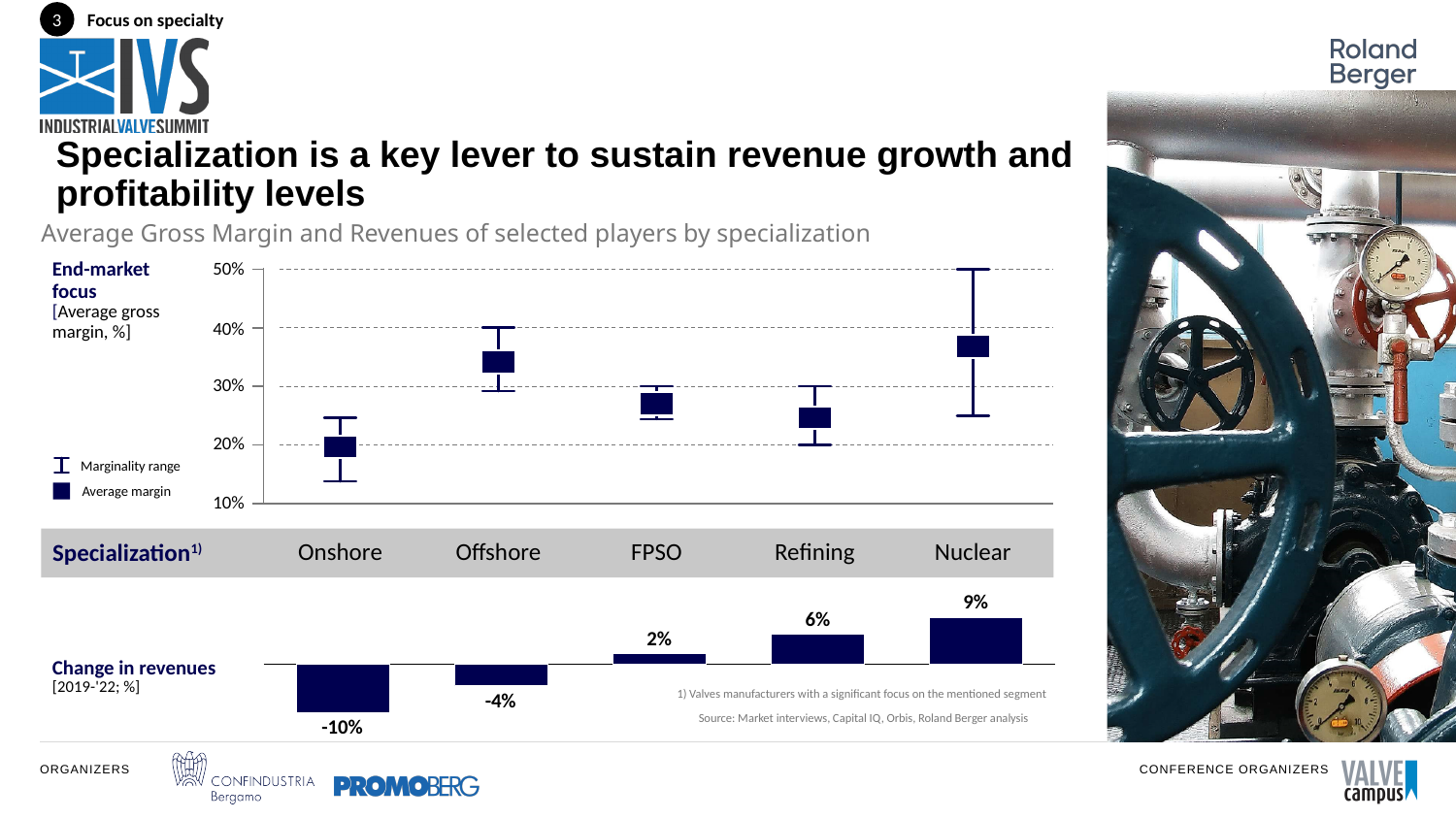
In the 'Change in revenues' bar chart, what is the value for FPSO? 2% What kind of chart is the 'Change in revenues' chart at the bottom of the slide? Bar chart In the 'Change in revenues' bar chart, what is the difference between the values for Refining and Offshore? 10 percentage points How many specializations are shown in the 'Change in revenues' bar chart? 5 In the 'Change in revenues' bar chart, which specialization has the highest change in revenues? Nuclear In the 'End-market focus' chart at the top, is the average margin for Offshore greater or less than 30%? greater In the 'Change in revenues' bar chart, which specialization has the lowest change in revenues? Onshore In the 'Change in revenues' bar chart, what is the value for Onshore? -10% In the 'Change in revenues' bar chart, what is the value for Nuclear? 9% In the 'Change in revenues' bar chart, which is larger, the value for Refining or the value for FPSO? Refining In the 'End-market focus' chart at the top, is the average margin for Refining greater or less than 30%? less In the 'End-market focus' chart at the top, which specialization has the lowest average gross margin? Onshore